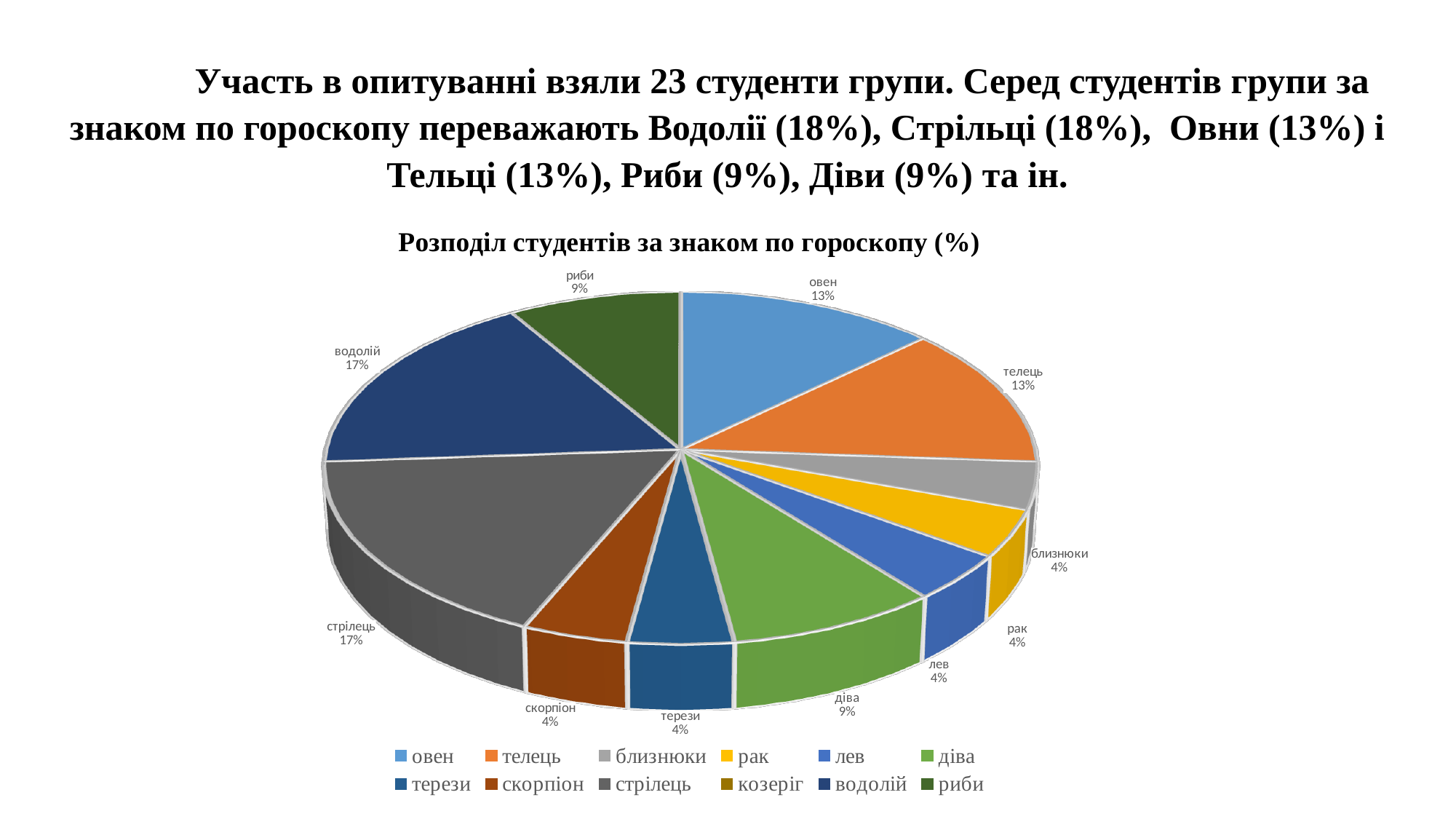
Which is larger, the share for телець or the share for лев? телець What is the value shown for риби? 9% What share of the pie does овен have? 13% What is the chart's title? Розподіл студентів за знаком по гороскопу (%) What is the value shown for діва? 9% What colour is the slice for телець? orange What is the value shown for водолій? 17% What is the value shown for скорпіон? 4% What type of chart is shown on the slide? pie chart How many categories does the legend list? 12 What is the value shown for стрілець? 17% What is the difference between the shares for водолій and риби? 8%